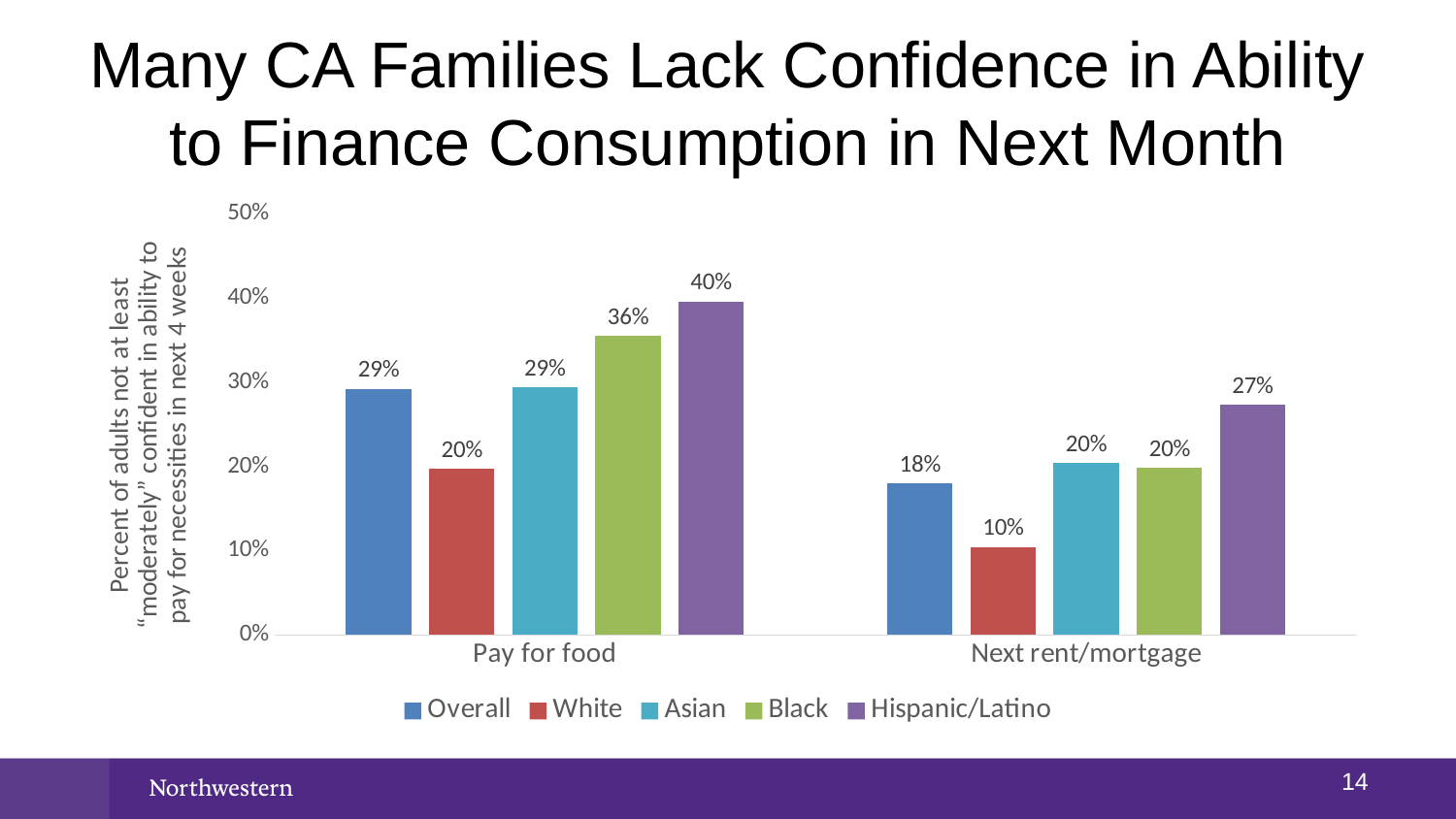
How many series does the legend list? 5 What is the value for Hispanic/Latino in the Pay for food category? 40% What is the value for White in the Next rent/mortgage category? 10% What kind of chart is shown on the slide? Bar chart How many categories are shown on the x axis? 2 Which series has the highest value in the Pay for food category? Hispanic/Latino Which is larger: the Black value for Pay for food or the Black value for Next rent/mortgage? Pay for food What is the difference between the Hispanic/Latino value and the White value in the Pay for food category? 20% What is the title of the chart on the slide? Many CA Families Lack Confidence in Ability to Finance Consumption in Next Month Which series has the lowest value in the Next rent/mortgage category? White What is the value for Overall in the Next rent/mortgage category? 18% What is the value for Black in the Pay for food category? 36%